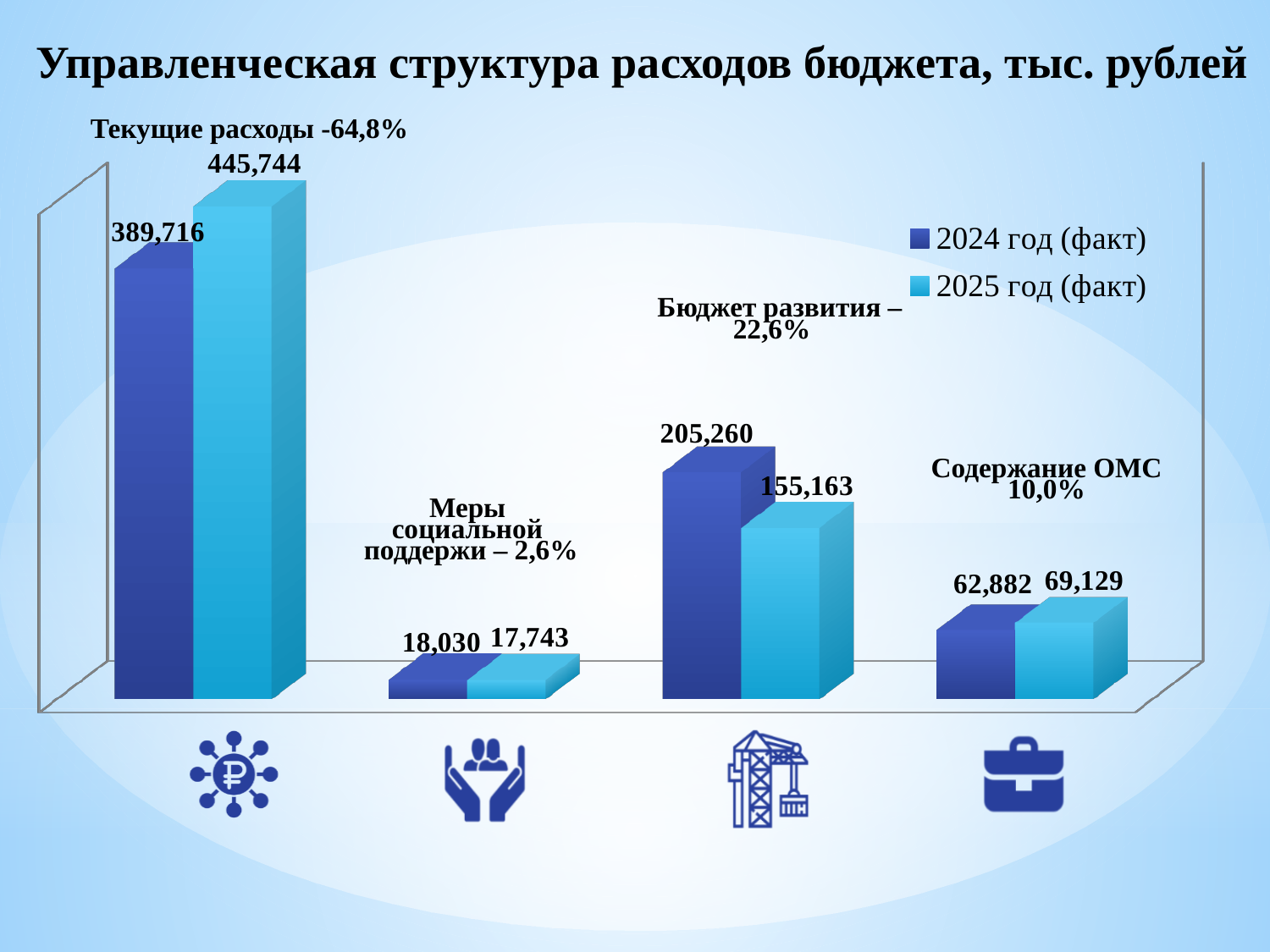
What is the value for Текущие расходы in the 2025 год (факт) series? 445,744 What is the difference between the 2025 год (факт) and 2024 год (факт) values for Текущие расходы? 56,028 For Содержание ОМС, which series has the larger value, 2024 год (факт) or 2025 год (факт)? 2025 год (факт) How many series does the legend list? 2 What is the value for Текущие расходы in the 2024 год (факт) series? 389,716 What kind of chart is shown on the slide? Bar chart What is the value for Содержание ОМС in the 2024 год (факт) series? 62,882 What is the difference between the 2024 год (факт) and 2025 год (факт) values for Бюджет развития? 50,097 How many categories are shown in the chart? 4 What is the value for Бюджет развития in the 2025 год (факт) series? 155,163 Which category has the highest value in the 2025 год (факт) series? Текущие расходы Which category has the lowest value in the 2024 год (факт) series? Меры социальной поддержки